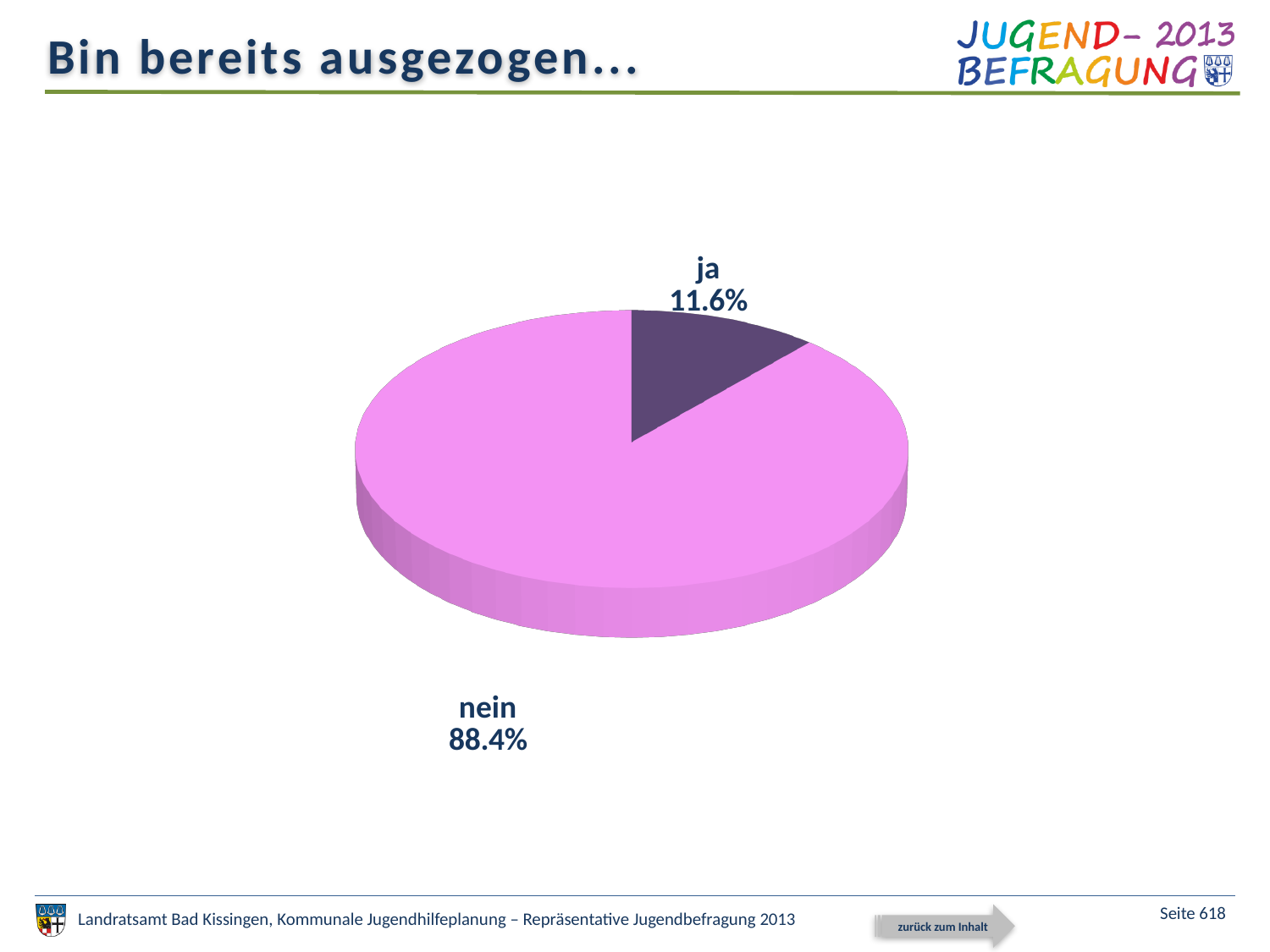
What is the difference in percentage points between the "nein" and "ja" slices? 76.8 What percentage of respondents answered "ja" in the pie chart? 11.6% What colour is the "nein" slice of the pie chart? pink How many slices does the pie chart have? 2 What share of the pie does the "ja" slice represent? 11.6% Which is larger, the share for "ja" or the share for "nein"? nein Which slice of the pie chart is the smallest? ja Which slice of the pie chart is the largest? nein What kind of chart is shown on the slide? pie chart What percentage of respondents answered "nein" in the pie chart? 88.4% What is the title of the slide containing the pie chart? Bin bereits ausgezogen...